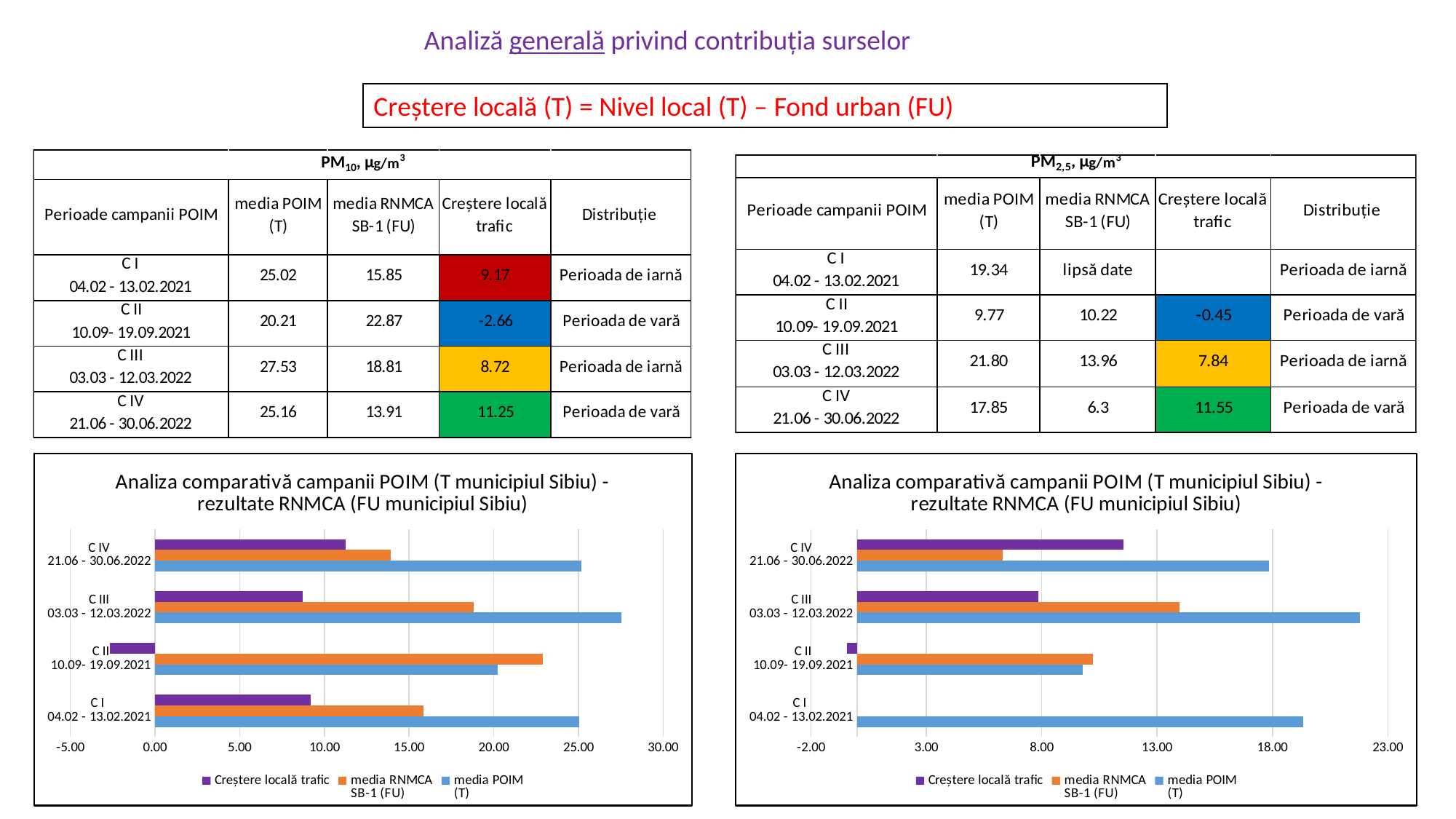
In the right chart, is the value of media POIM (T) for C I 04.02 - 13.02.2021 greater or less than 18.00? greater In the right chart, is the value of Creștere locală trafic for C II 10.09- 19.09.2021 greater or less than 3.00? less What kind of chart is the left chart on the slide? bar chart In the right chart, how many bars are plotted for the category C I 04.02 - 13.02.2021? 1 In the left chart, which campaign has the lowest Creștere locală trafic value? C II 10.09- 19.09.2021 In the left chart, is the value of media POIM (T) for C III 03.03 - 12.03.2022 greater or less than 25.00? greater How many campaign categories are shown on the y axis of the left chart? 4 In the left chart, which campaign has the highest media POIM (T) value? C III 03.03 - 12.03.2022 How many series does the legend of the right chart list? 3 In the right chart, what is the difference between media POIM (T) and media RNMCA SB-1 (FU) for C III 03.03 - 12.03.2022, using the values in the PM2,5 table? 7.84 In the right chart, for C IV 21.06 - 30.06.2022, which is larger: media POIM (T) or media RNMCA SB-1 (FU)? media POIM (T) In the left chart, what is the value of Creștere locală trafic for C IV 21.06 - 30.06.2022, as given in the PM10 table above it? 11.25